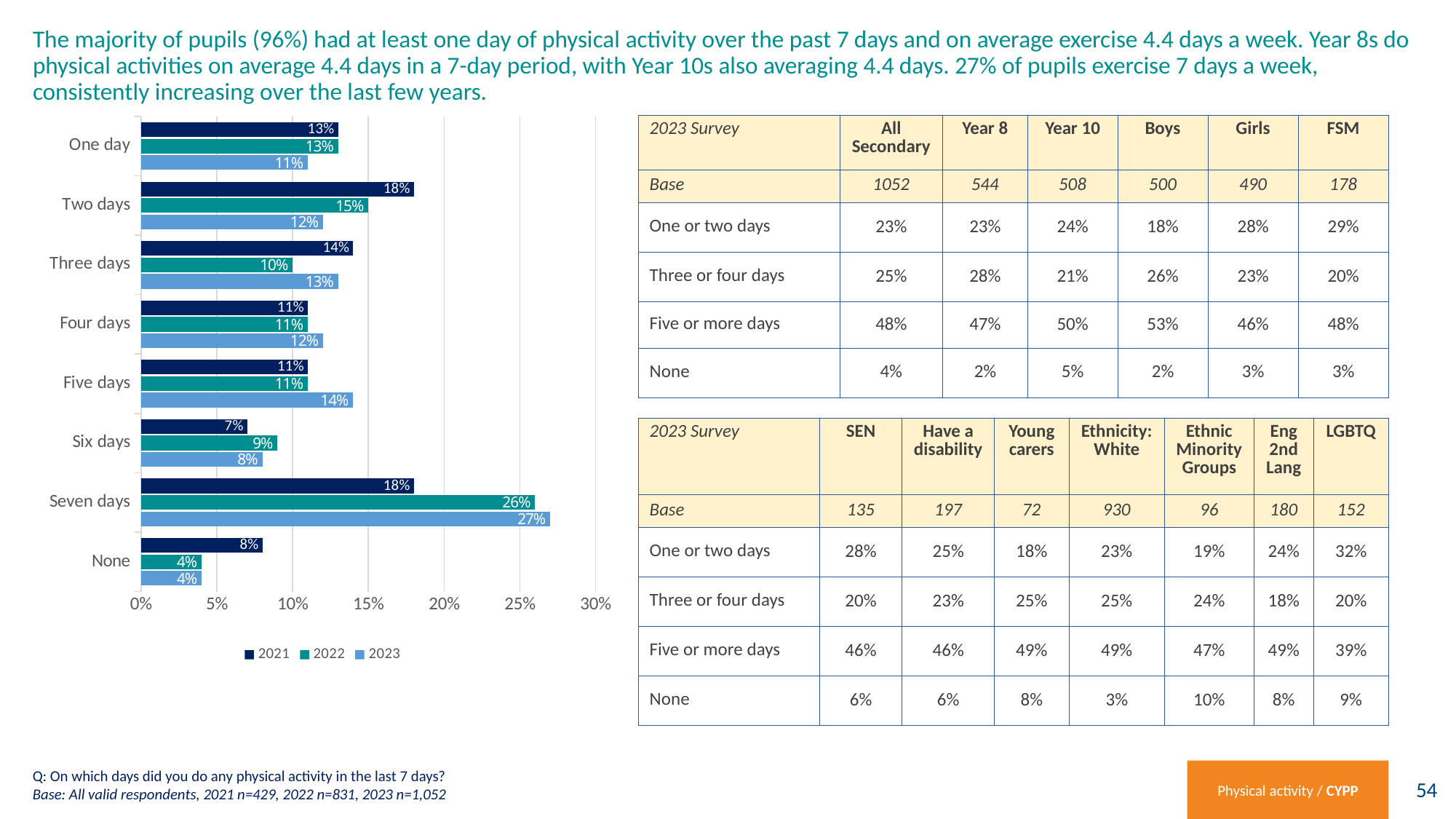
What is the difference between the 2022 and 2021 values for Seven days? 8% What is the 2022 value for Three days? 10% What kind of chart is shown on the slide? bar chart How many series does the chart legend list? 3 Which is larger for Two days, the 2021 value or the 2023 value? 2021 What is the 2023 value for Seven days? 27% Which category has the highest 2022 value? Seven days Which category has the lowest 2023 value? None Which series in the legend is shown in the darkest blue colour? 2021 What is the 2021 value for Two days? 18% How many categories are shown on the chart's vertical axis? 8 Is the 2023 value for Seven days greater or less than 25%? greater